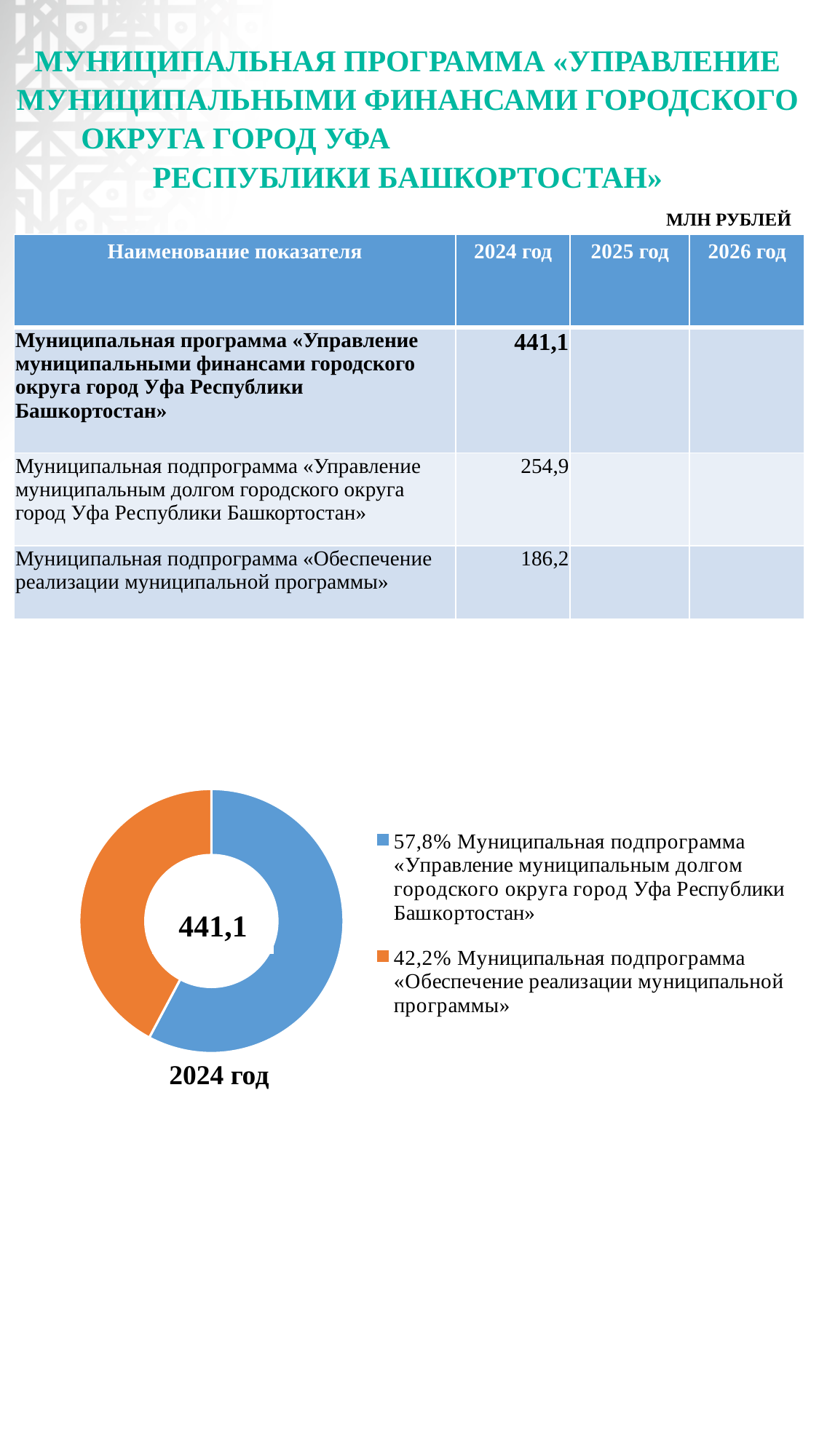
What share of the doughnut chart does the subprogram «Обеспечение реализации муниципальной программы» take? 42,2% How many slices does the doughnut chart have? 2 What is the difference in percentage points between the two slices of the doughnut chart? 15,6 Which slice of the doughnut chart is the smallest? Муниципальная подпрограмма «Обеспечение реализации муниципальной программы» How many entries does the legend of the doughnut chart list? 2 What year is the doughnut chart labelled with? 2024 год Which slice of the doughnut chart is the largest? Муниципальная подпрограмма «Управление муниципальным долгом городского округа город Уфа Республики Башкортостан» What total value is printed in the centre of the doughnut chart? 441,1 What kind of chart is shown on the slide? doughnut (pie) chart What colour is the slice for «Обеспечение реализации муниципальной программы» in the doughnut chart? orange Which is larger in the doughnut chart: the share of «Управление муниципальным долгом» or the share of «Обеспечение реализации муниципальной программы»? «Управление муниципальным долгом» What share of the doughnut chart does the subprogram «Управление муниципальным долгом городского округа город Уфа Республики Башкортостан» take? 57,8%